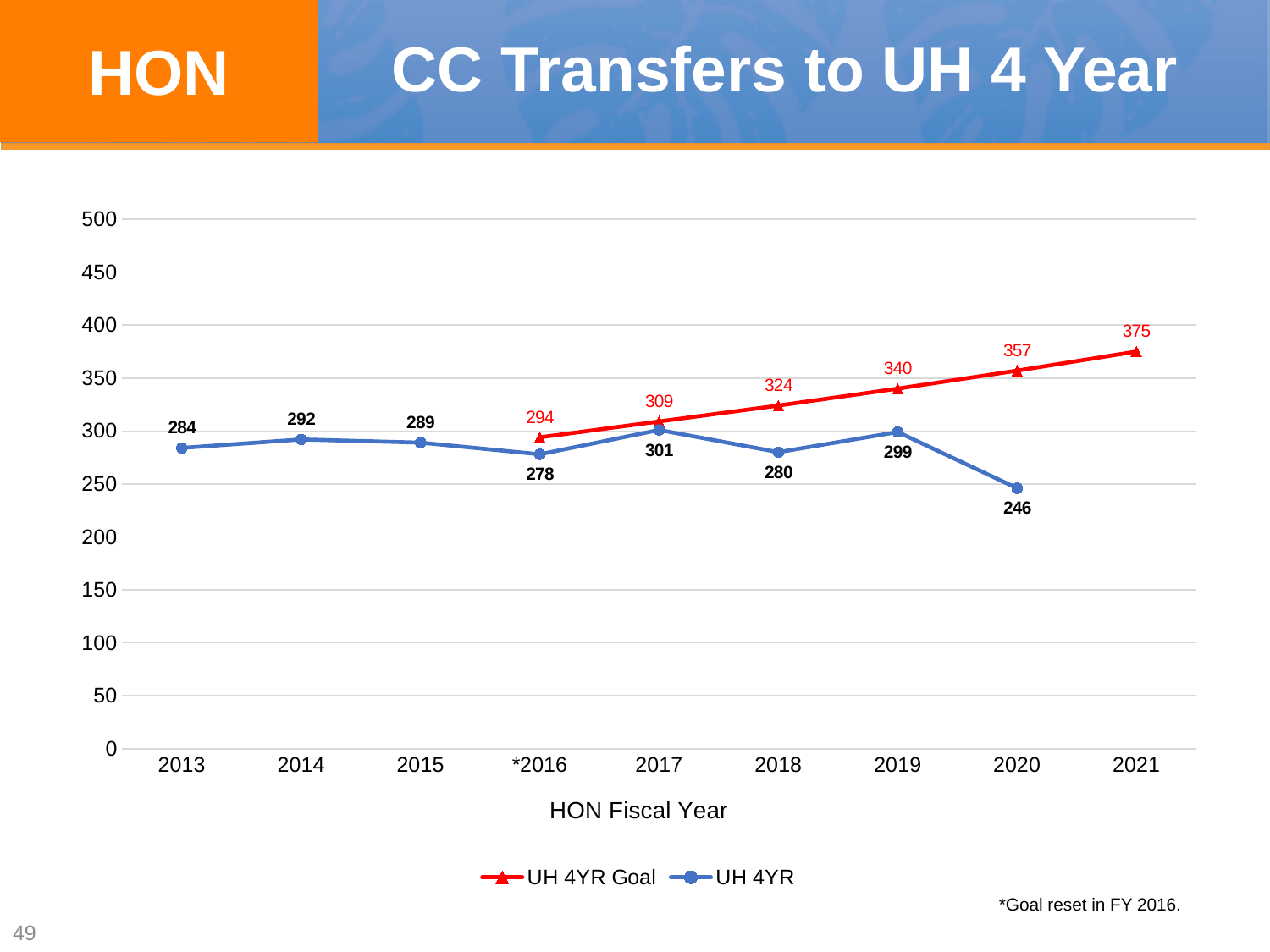
What is the UH 4YR Goal value for 2021? 375 What kind of chart is shown on the slide? line chart Which year has the highest UH 4YR value? 2017 Which is larger in 2018, the UH 4YR Goal or the UH 4YR value? UH 4YR Goal What is the difference between the UH 4YR Goal and the UH 4YR value in 2019? 41 How many series does the legend list? 2 What is the UH 4YR value for 2020? 246 Does the UH 4YR Goal series rise or fall from 2016 to 2021? rise What is the UH 4YR value for 2013? 284 How many years are shown on the x axis? 9 Is the UH 4YR value for 2020 greater or less than 250? less Which year has the lowest UH 4YR value? 2020